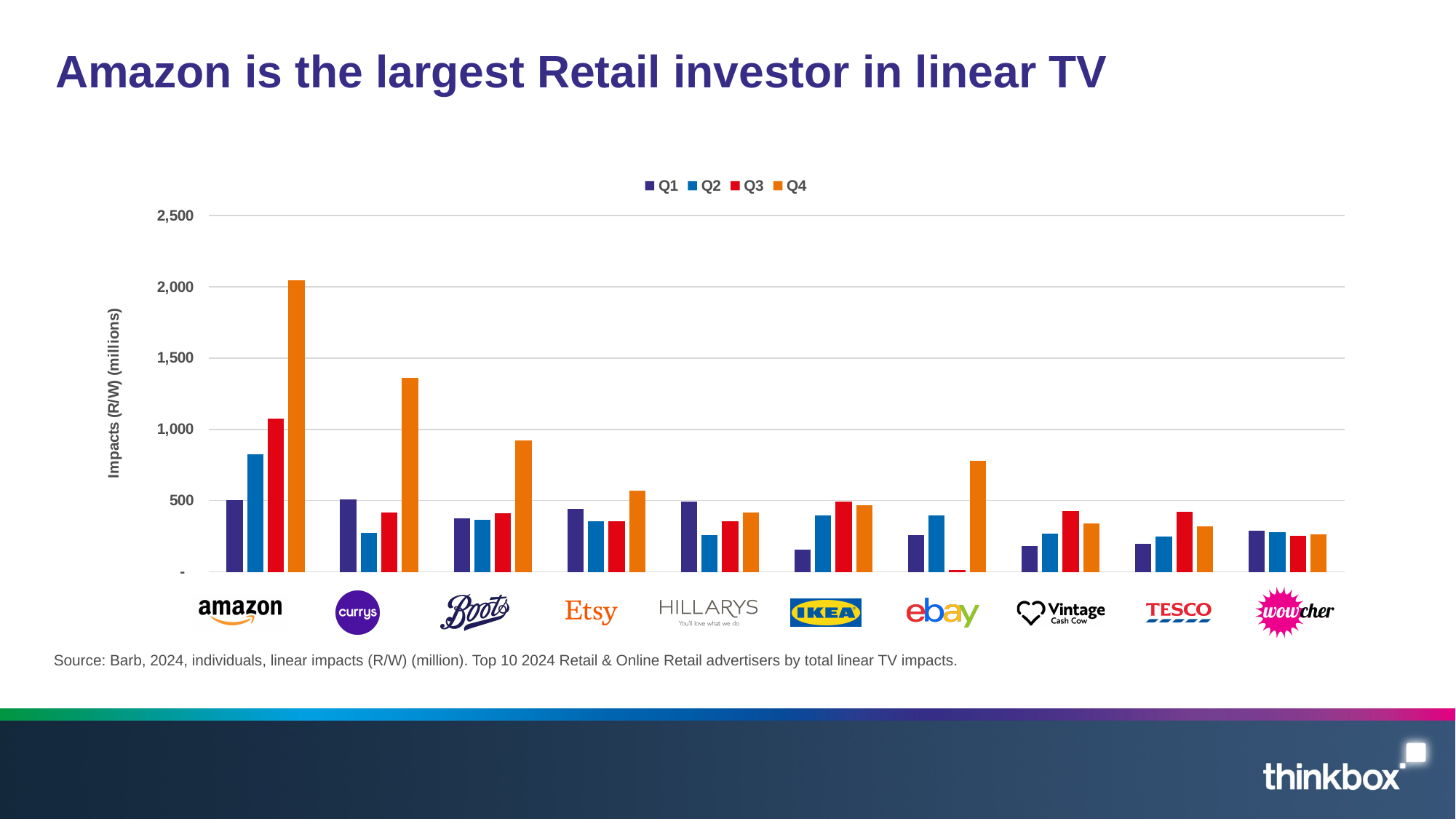
Is the Q4 value for Amazon greater or less than 2,000? greater For Amazon, which quarter has the highest impacts? Q4 Which advertiser and quarter has the lowest bar on the chart? eBay, Q3 What is the label of the y axis? Impacts (R/W) (millions) Is the Q4 value for Boots greater or less than 1,000? less Is the Q4 value for Currys greater or less than 1,000? greater How many series does the legend list? 4 How many advertisers are shown along the x axis? 10 Which is larger for Currys: the Q2 value or the Q3 value? Q3 What kind of chart is shown on the slide? bar chart Which advertiser has the tallest bar on the chart? Amazon